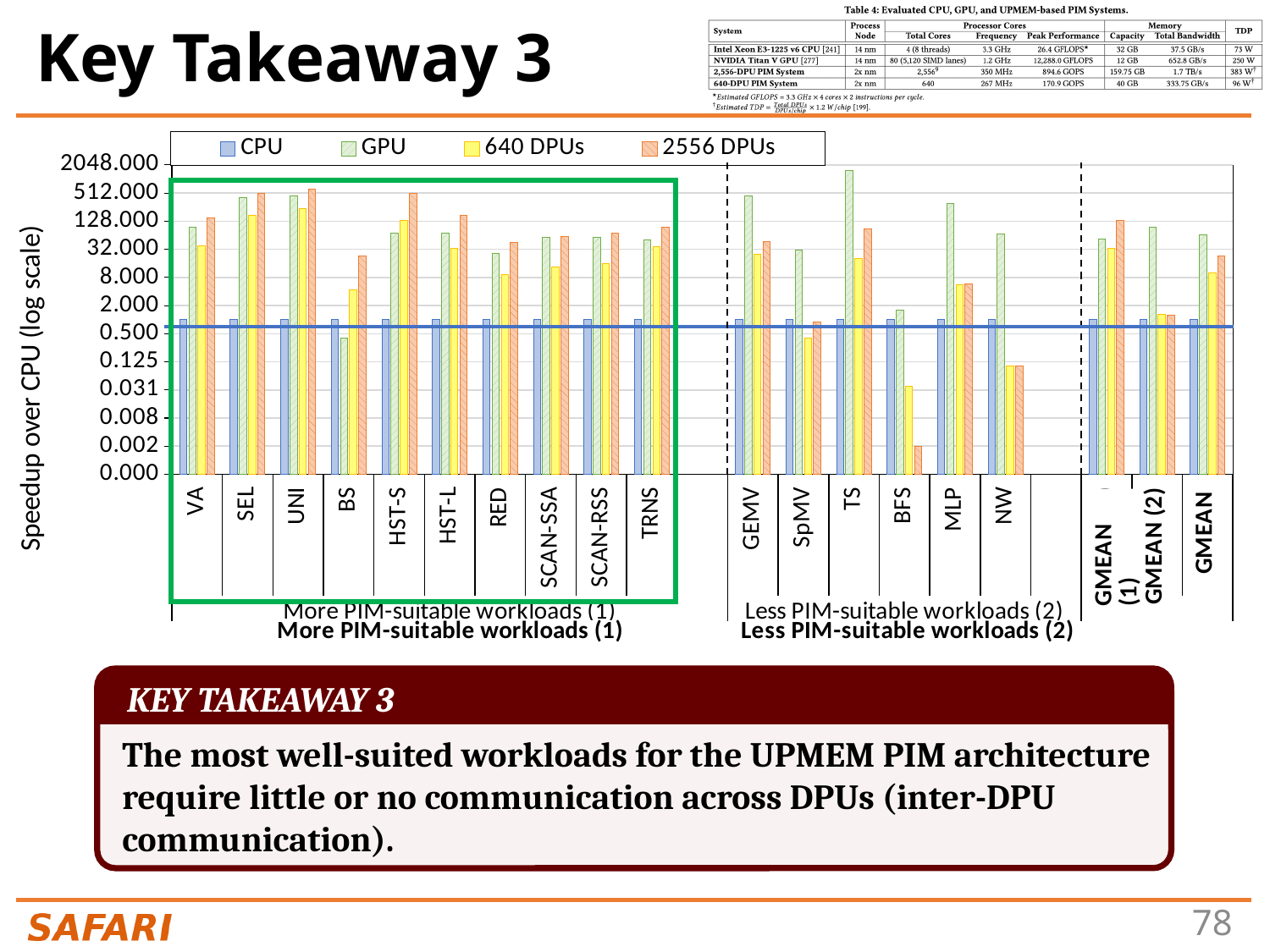
Is the GPU value for TS greater or less than 512.000? greater For MLP, which is larger: the GPU value or the 2556 DPUs value? GPU How many series does the chart legend list? 4 What kind of chart is shown on the slide? bar chart Which workload has the lowest GPU bar in the chart? BS Is the 2556 DPUs value for BFS greater or less than 0.008? less Which workload has the highest GPU bar in the chart? TS What are the four series listed in the chart legend? CPU, GPU, 640 DPUs, 2556 DPUs What is the label of the chart's y axis? Speedup over CPU (log scale) Which workload has the lowest 2556 DPUs bar in the chart? BFS Is the GPU value for GEMV greater or less than 128.000? greater How many workload categories are shown along the x axis of the chart? 19